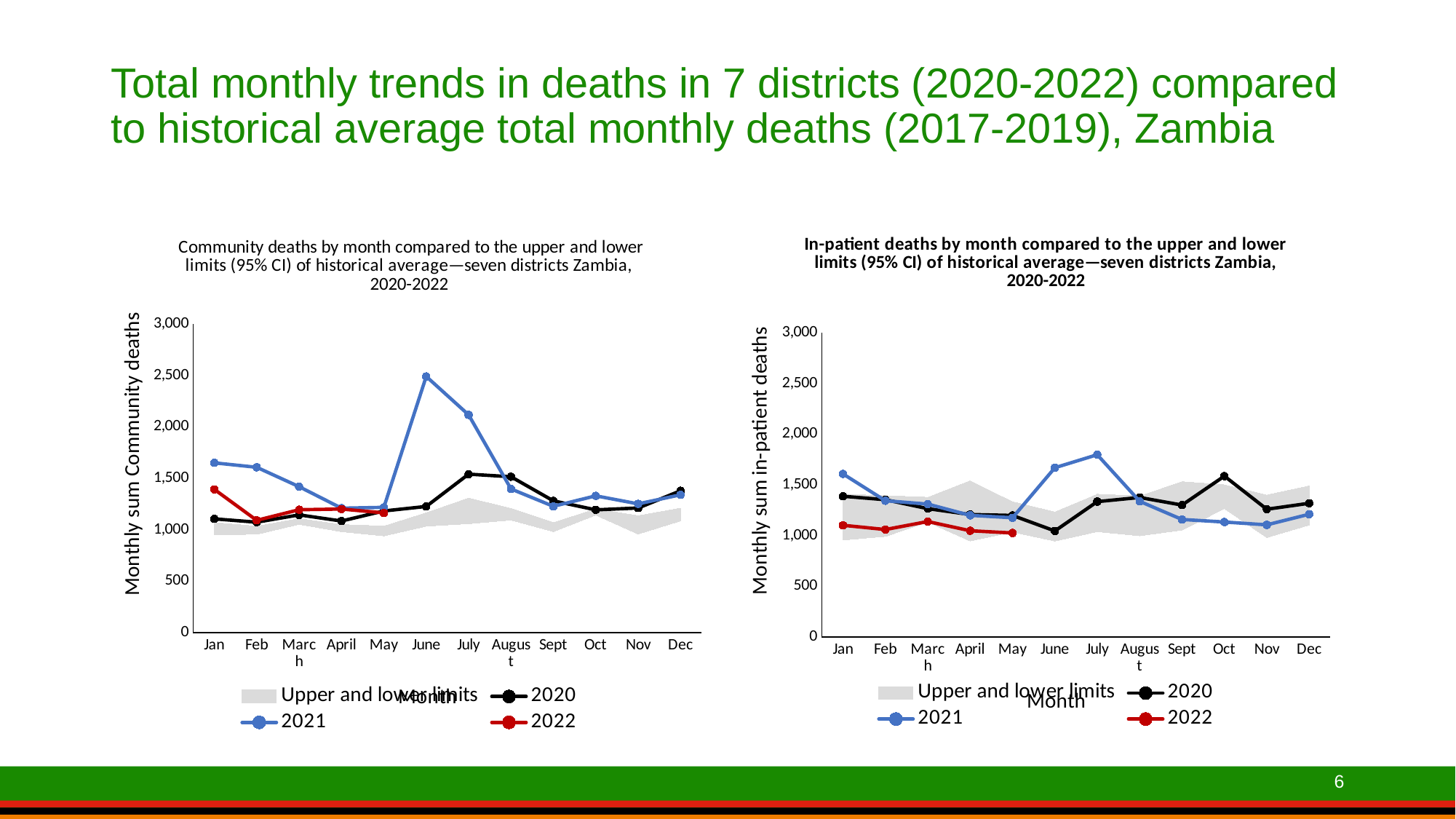
In the 'In-patient deaths by month' chart on the right, is the 2021 value for July greater or less than 1,500? greater In the 'In-patient deaths by month' chart on the right, in which month does the 2020 series reach its lowest value? June In the 'Community deaths by month' chart on the left, in which month does the 2021 series reach its highest value? June How many series does the legend of the 'In-patient deaths by month' chart on the right list? 4 In the 'Community deaths by month' chart on the left, which is larger in June: the 2020 value or the 2021 value? 2021 In the 'In-patient deaths by month' chart on the right, in which month does the 2021 series reach its highest value? July In the 'In-patient deaths by month' chart on the right, which is larger in Jan: the 2020 value or the 2022 value? 2020 In the 'Community deaths by month' chart on the left, does the 2021 series rise or fall from June to Sept? fall In the 'Community deaths by month' chart on the left, is the 2020 value for Jan greater or less than 1,500? less How many months are shown on the x axis of the 'Community deaths by month' chart on the left? 12 In the 'Community deaths by month' chart on the left, is the 2021 value for June greater or less than 2,000? greater What kind of chart is the 'Community deaths by month' chart on the left? line chart